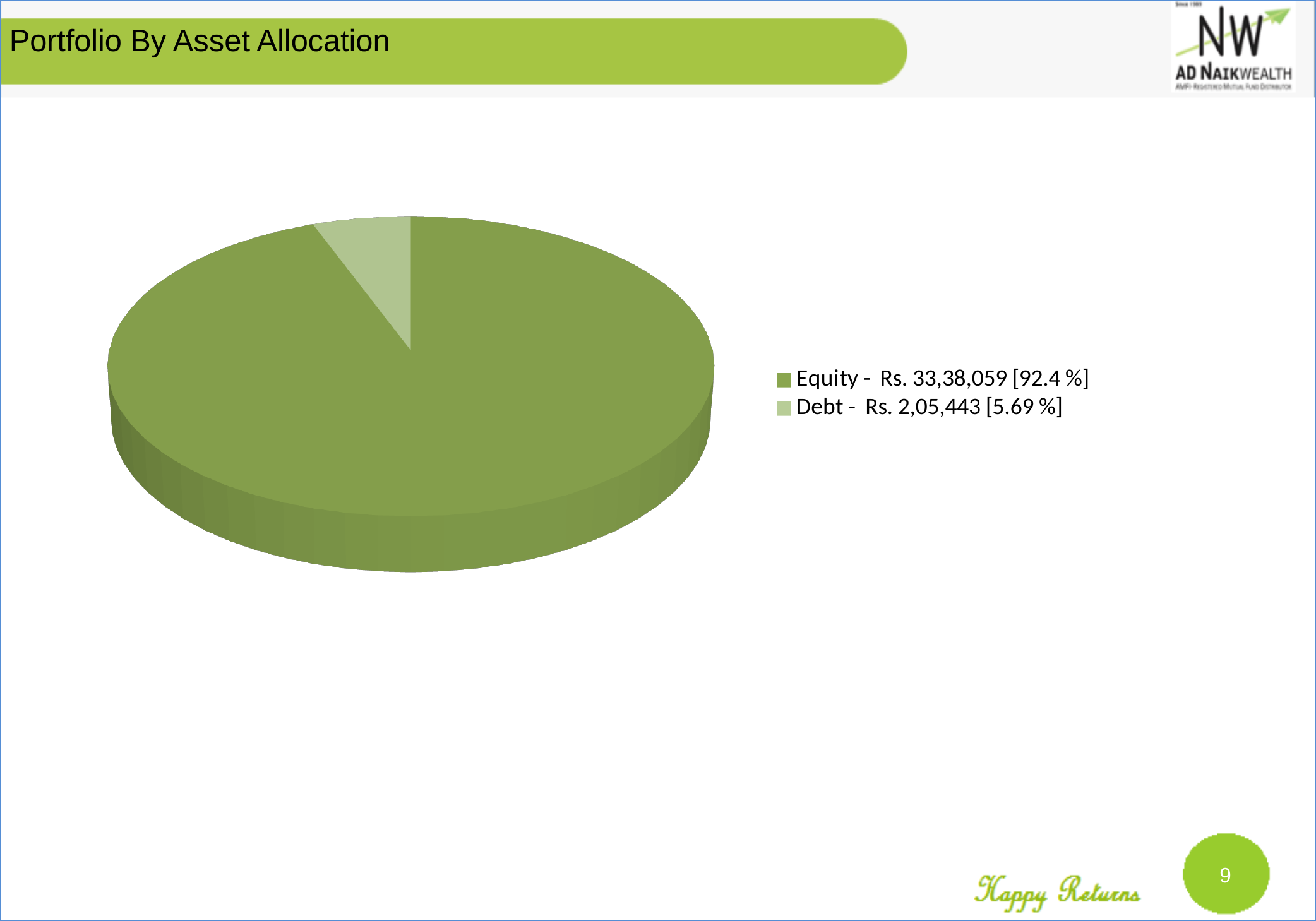
Which category is shown in the lighter green colour in the pie chart? Debt Which category has the smallest slice of the pie? Debt What share of the pie does Debt represent? 5.69 % What is the title of the slide containing the pie chart? Portfolio By Asset Allocation How many categories are shown in the pie chart? 2 What is the value for Equity in the pie chart? Rs. 33,38,059 Which is larger, Equity or Debt? Equity What is the difference in value between Equity and Debt? Rs. 31,32,616 What kind of chart is shown on the slide? Pie chart What is the value for Debt in the pie chart? Rs. 2,05,443 What share of the pie does Equity represent? 92.4 % Which category has the largest slice of the pie? Equity